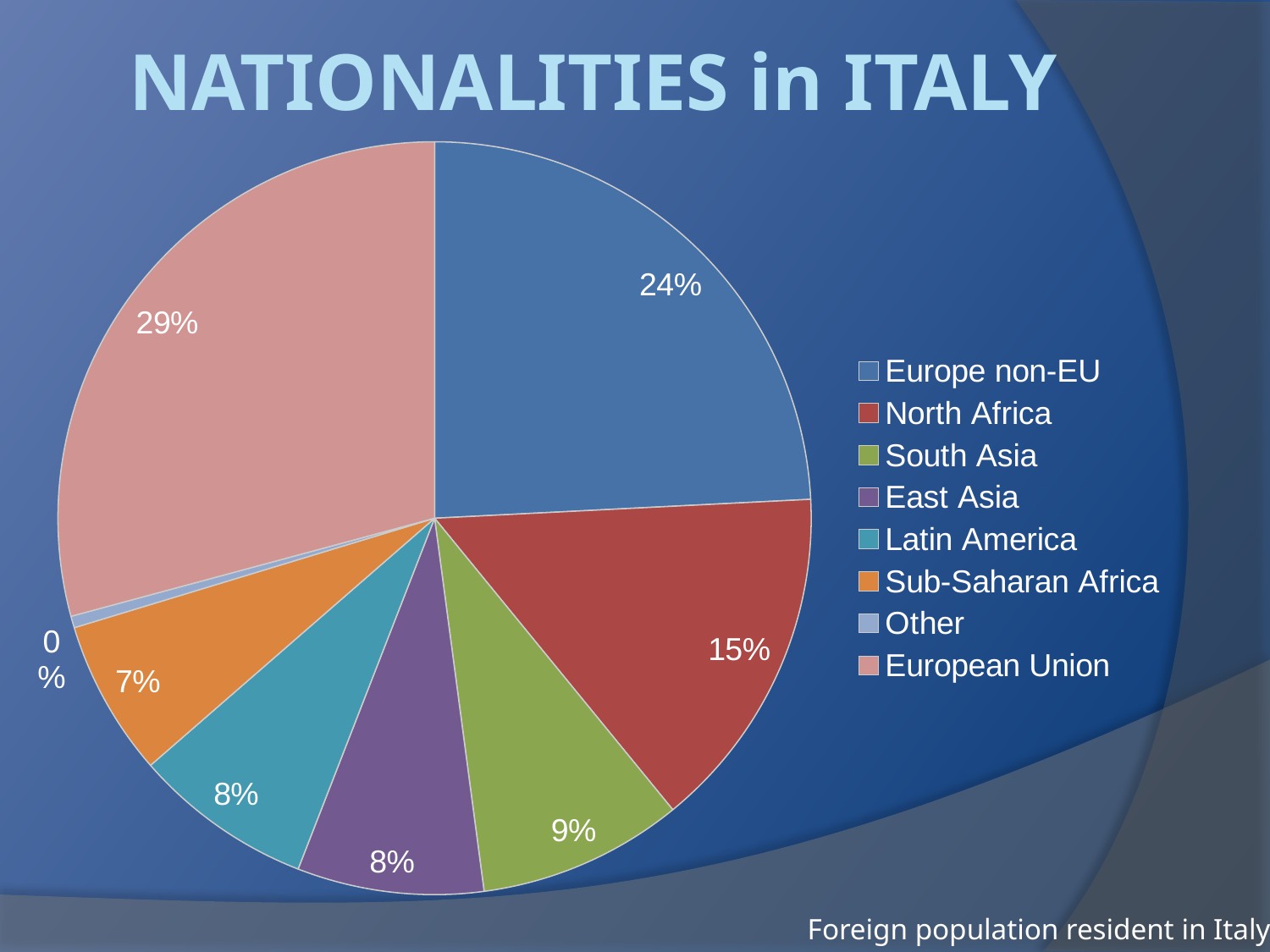
What percentage of the pie is North Africa? 15% What is the difference in percentage points between European Union and Europe non-EU? 5 Which category has the largest share of the pie? European Union What percentage of the pie is Sub-Saharan Africa? 7% What percentage of the pie is South Asia? 9% What percentage of the pie is European Union? 29% What percentage of the pie is Europe non-EU? 24% What kind of chart is shown on the slide? pie chart Which category has the smallest share of the pie? Other How many categories does the legend list? 8 Which is larger, North Africa or South Asia? North Africa What is the title of the chart slide? NATIONALITIES in ITALY